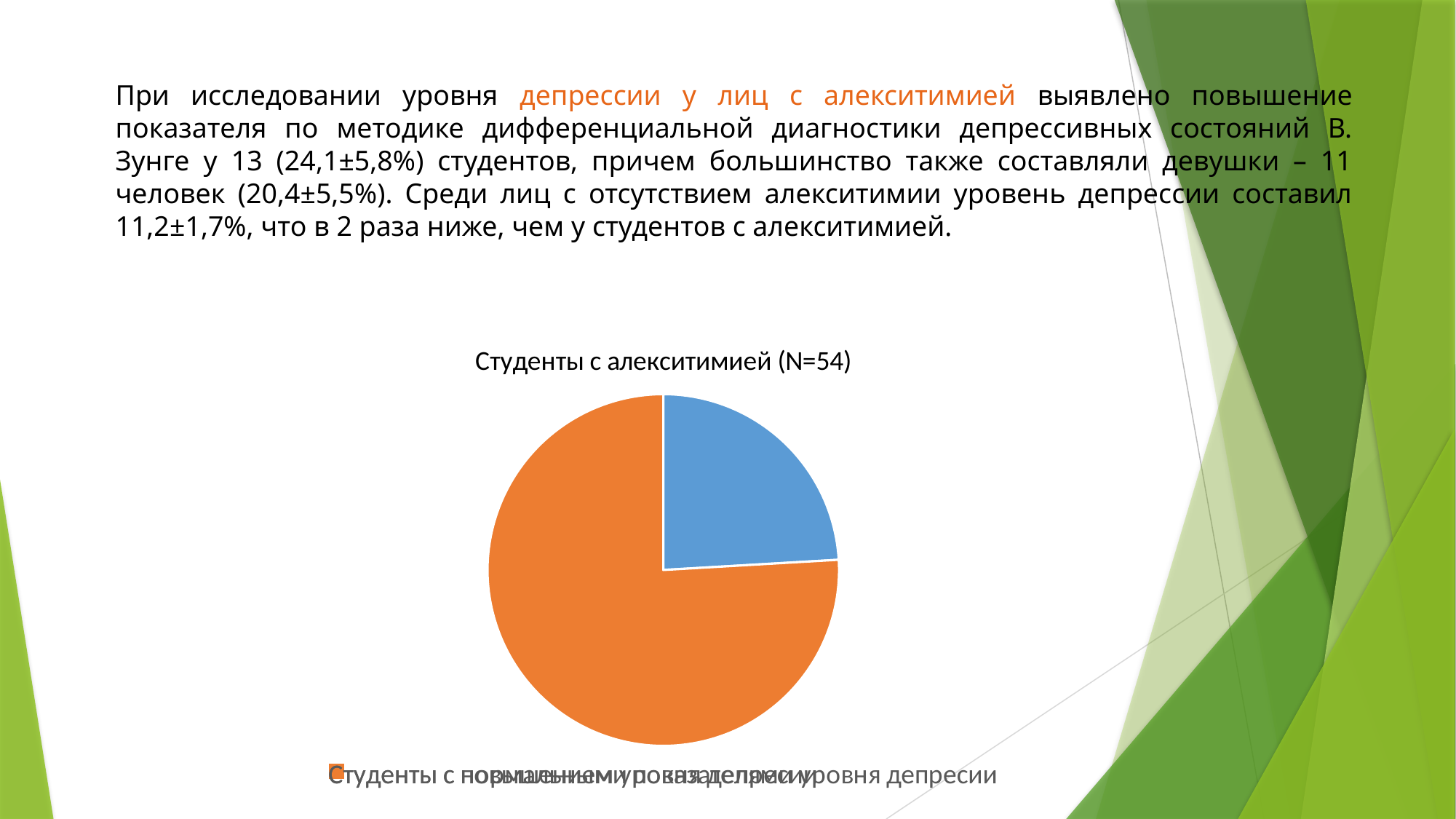
Which slice of the pie chart is larger, the orange one or the blue one? the orange one Which colour is the largest slice of the pie chart? orange Which colour is the smallest slice of the pie chart? blue What is the title of the pie chart? Студенты с алекситимией (N=54) What kind of chart is shown on the slide? pie chart What sample size (N) is given in the pie chart's title? 54 How many slices does the pie chart have? 2